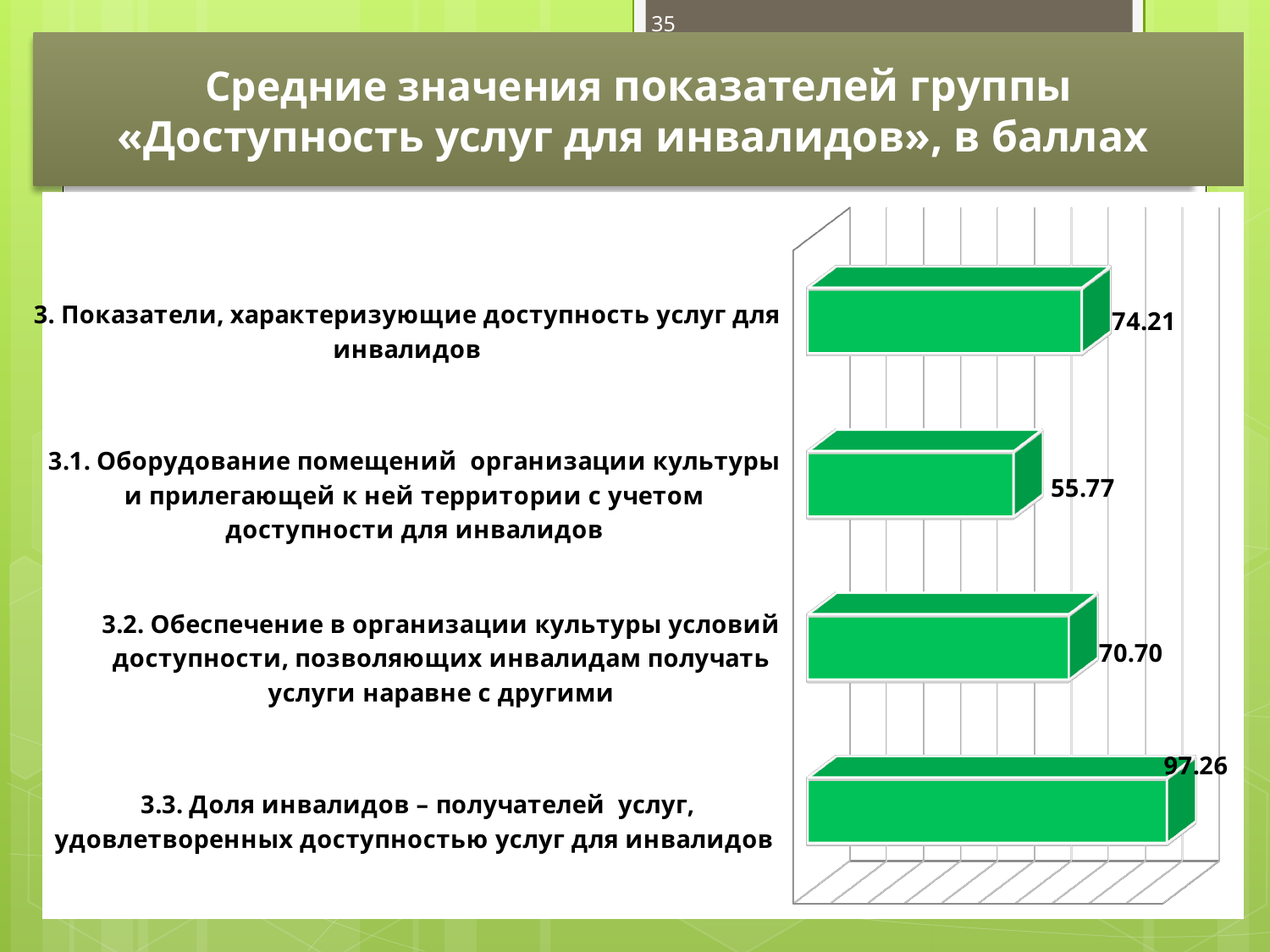
What is the value for category 3.1 «Оборудование помещений организации культуры и прилегающей к ней территории с учетом доступности для инвалидов»? 55.77 What is the difference between the values for category 3 and category 3.2? 3.51 What is the value for category 3.2 «Обеспечение в организации культуры условий доступности, позволяющих инвалидам получать услуги наравне с другими»? 70.70 What kind of chart is shown on the slide? Bar chart How many categories are shown in the chart? 4 Which category has the highest value? 3.3. Доля инвалидов – получателей услуг, удовлетворенных доступностью услуг для инвалидов What is the value for category 3 «Показатели, характеризующие доступность услуг для инвалидов»? 74.21 Which is larger: the value for category 3 or the value for category 3.1? Category 3 (74.21) What is the title of the chart on the slide? Средние значения показателей группы «Доступность услуг для инвалидов», в баллах What is the value for category 3.3 «Доля инвалидов – получателей услуг, удовлетворенных доступностью услуг для инвалидов»? 97.26 What is the difference between the values for category 3.3 and category 3.1? 41.49 Which category has the lowest value? 3.1. Оборудование помещений организации культуры и прилегающей к ней территории с учетом доступности для инвалидов